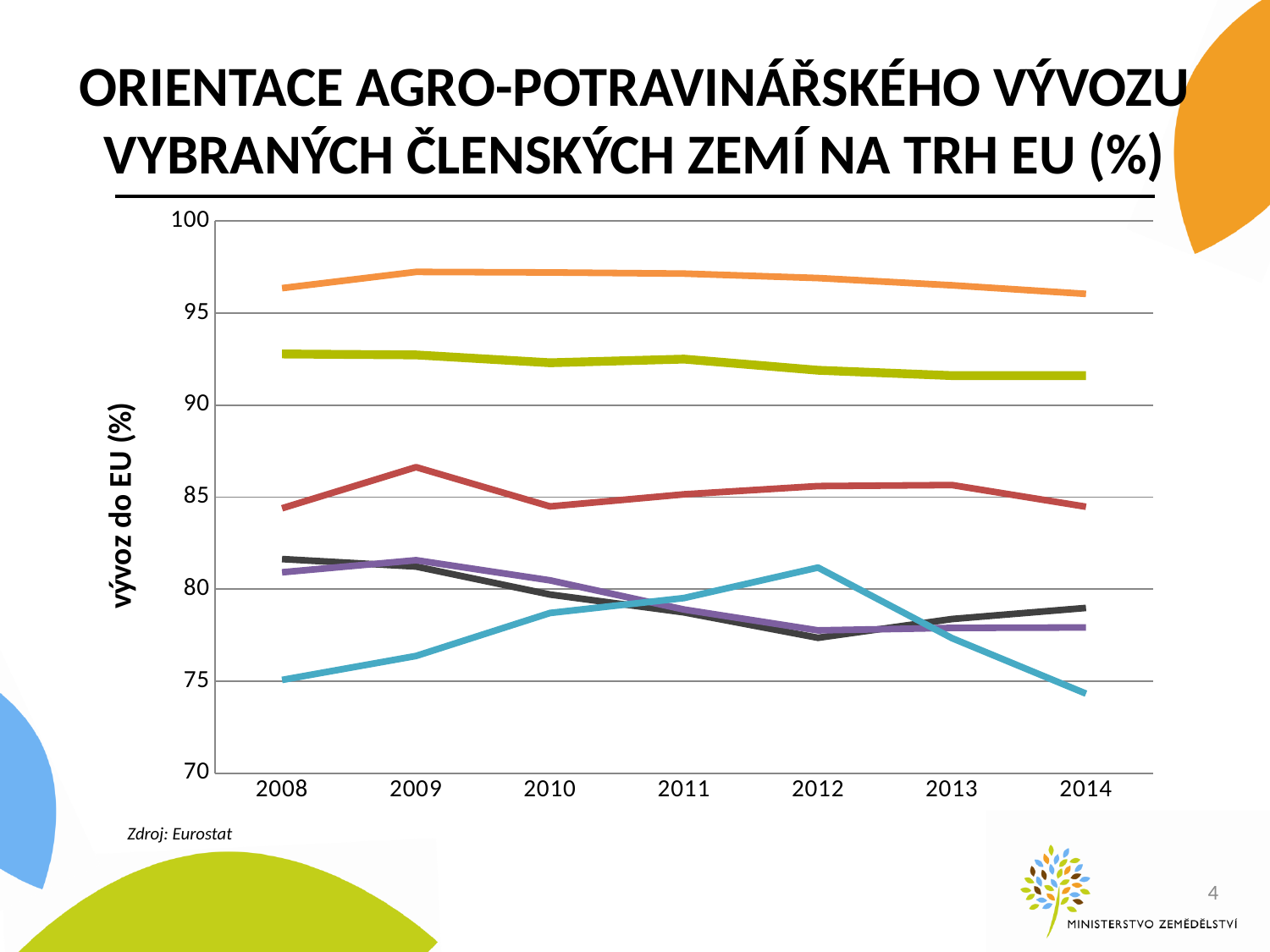
Which line has the lowest value in 2014? the light blue line Is the value of the olive green line in 2014 greater or less than 90? greater Is the value of the red line in 2009 greater or less than 85? greater What kind of chart is shown on the slide? line chart Does the light blue line rise or fall between 2008 and 2012? rise Which line has the highest values throughout the whole period? the orange line Does the light blue line rise or fall between 2012 and 2014? fall What is the title of the vertical axis? vývoz do EU (%) How many years are plotted along the x axis? 7 Is the value of the light blue line in 2008 greater or less than 80? less What source is cited below the chart? Eurostat